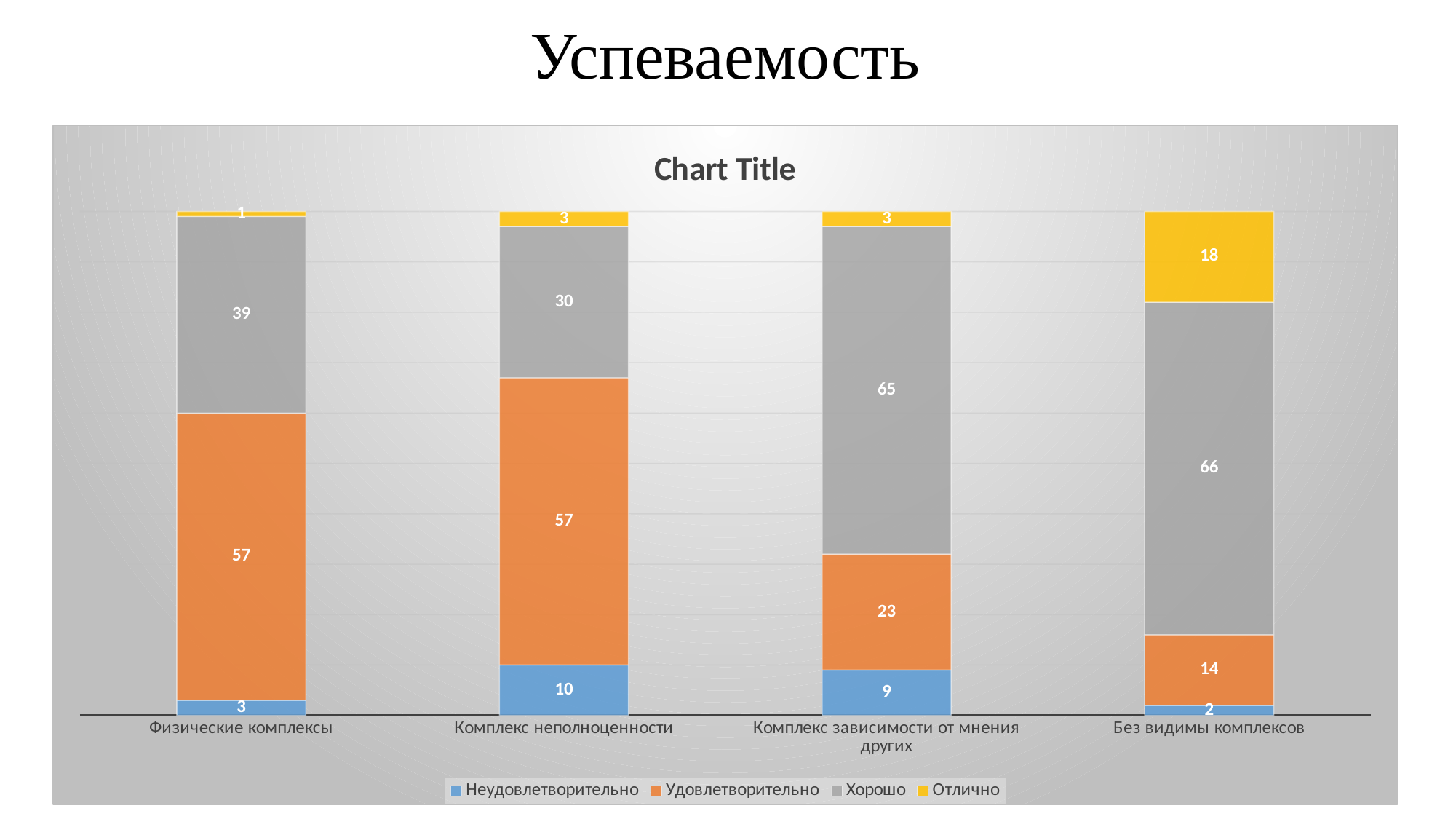
What is the value of Неудовлетворительно for Комплекс неполноценности? 10 How many categories are shown on the x axis? 4 How many series does the legend list? 4 What is the total of the stacked bar for Комплекс неполноценности? 100 What is the value of Хорошо for Комплекс зависимости от мнения других? 65 Which is larger: the Удовлетворительно value for Физические комплексы or for Комплекс зависимости от мнения других? Физические комплексы Which category has the highest value for Отлично? Без видимы комплексов Which category has the lowest value for Удовлетворительно? Без видимы комплексов What kind of chart is shown on the slide? Stacked bar chart What colour represents the Отлично series in the legend? Yellow What is the value of Отлично for Без видимы комплексов? 18 What is the difference between the Хорошо values for Без видимы комплексов and Физические комплексы? 27